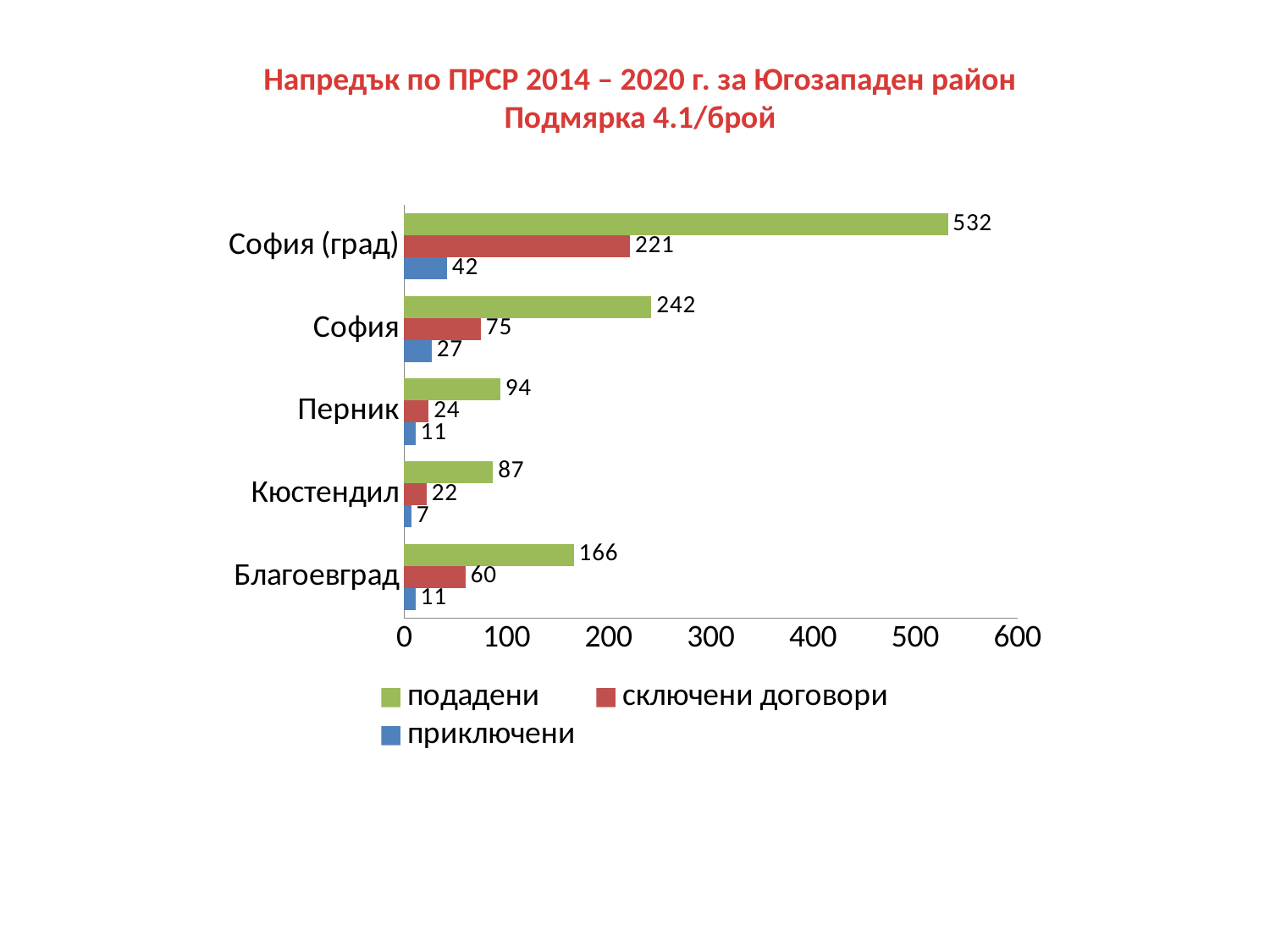
Which is larger: сключени договори for Перник or сключени договори for Кюстендил? Перник Which colour represents the приключени series? blue What is the value of приключени for София? 27 How many series does the legend list? 3 What kind of chart is shown on the slide? bar chart Which category has the highest value for подадени? София (град) What is the value of сключени договори for Благоевград? 60 Which category has the lowest value for приключени? Кюстендил How many categories are shown on the chart? 5 What is the difference between подадени and сключени договори for София? 167 What is the value of подадени for София (град)? 532 Is the value of подадени for Благоевград greater or less than 100? greater